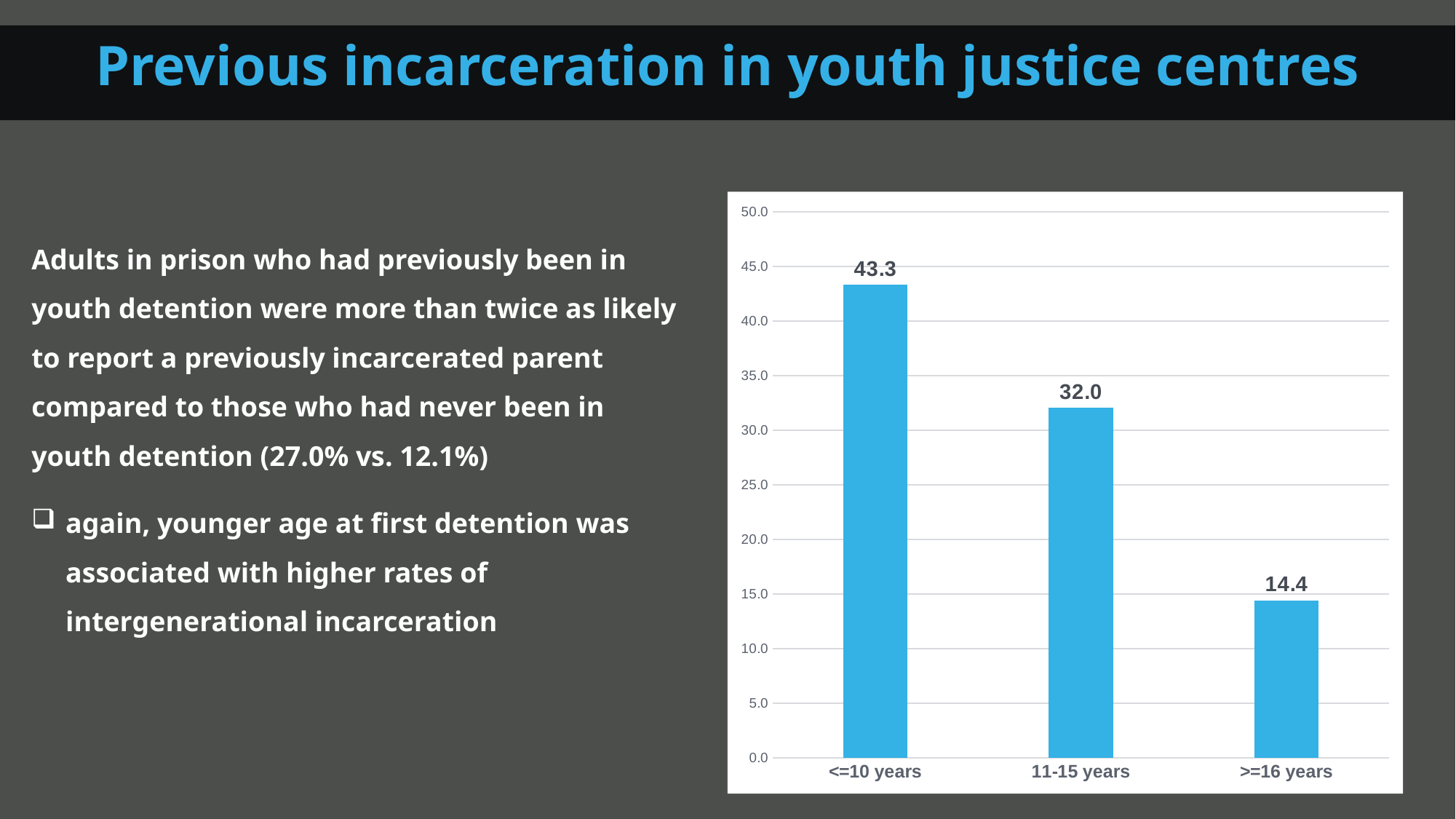
What is the value for the >=16 years category? 14.4 What is the value for the <=10 years category? 43.3 What is the difference between the values for <=10 years and 11-15 years? 11.3 How many categories are shown on the x axis? 3 What kind of chart is shown on the slide? bar chart Which category has the lowest value? >=16 years What is the value for the 11-15 years category? 32.0 What is the difference between the values for <=10 years and >=16 years? 28.9 Which category has the highest value? <=10 years Which is larger, the value for 11-15 years or the value for >=16 years? 11-15 years Is the value for 11-15 years greater or less than 30.0? greater Do the values rise or fall from left to right along the x axis? fall